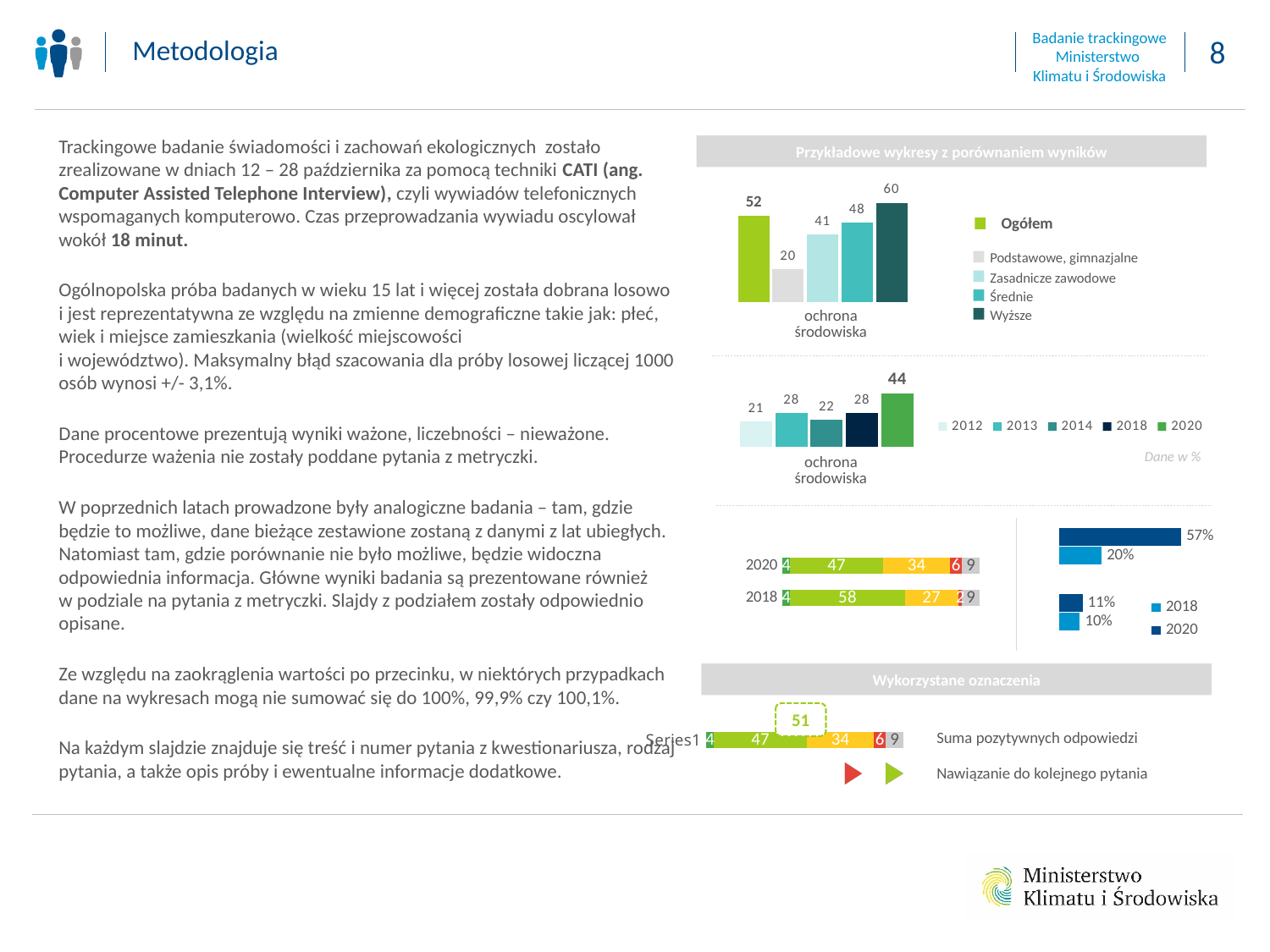
In the top-right bar chart broken down by education level, what is the value for Podstawowe, gimnazjalne? 20 In the stacked horizontal bar chart with rows 2020 and 2018, what is the difference between the second segment of the 2018 row (58) and the second segment of the 2020 row (47)? 11 How many series does the legend of the top-right bar chart broken down by education level list? 5 In the top-right bar chart broken down by education level, which series has the highest value? Wyższe In the middle-right bar chart comparing years, which year has the lowest value? 2012 In the middle-right bar chart comparing years, what is the value for 2020? 44 In the middle-right bar chart comparing years, is the value for 2014 larger or smaller than the value for 2013? smaller What type of chart is the middle-right chart comparing the years 2012 to 2020? bar chart In the top-right bar chart broken down by education level, which series has the lowest value? Podstawowe, gimnazjalne In the stacked horizontal bar chart with rows 2020 and 2018, what is the value of the largest segment in the 2018 row? 58 In the top-right bar chart broken down by education level, what is the difference between the Ogółem value and the Średnie value? 4 In the top-right bar chart broken down by education level, what is the value for Wyższe? 60